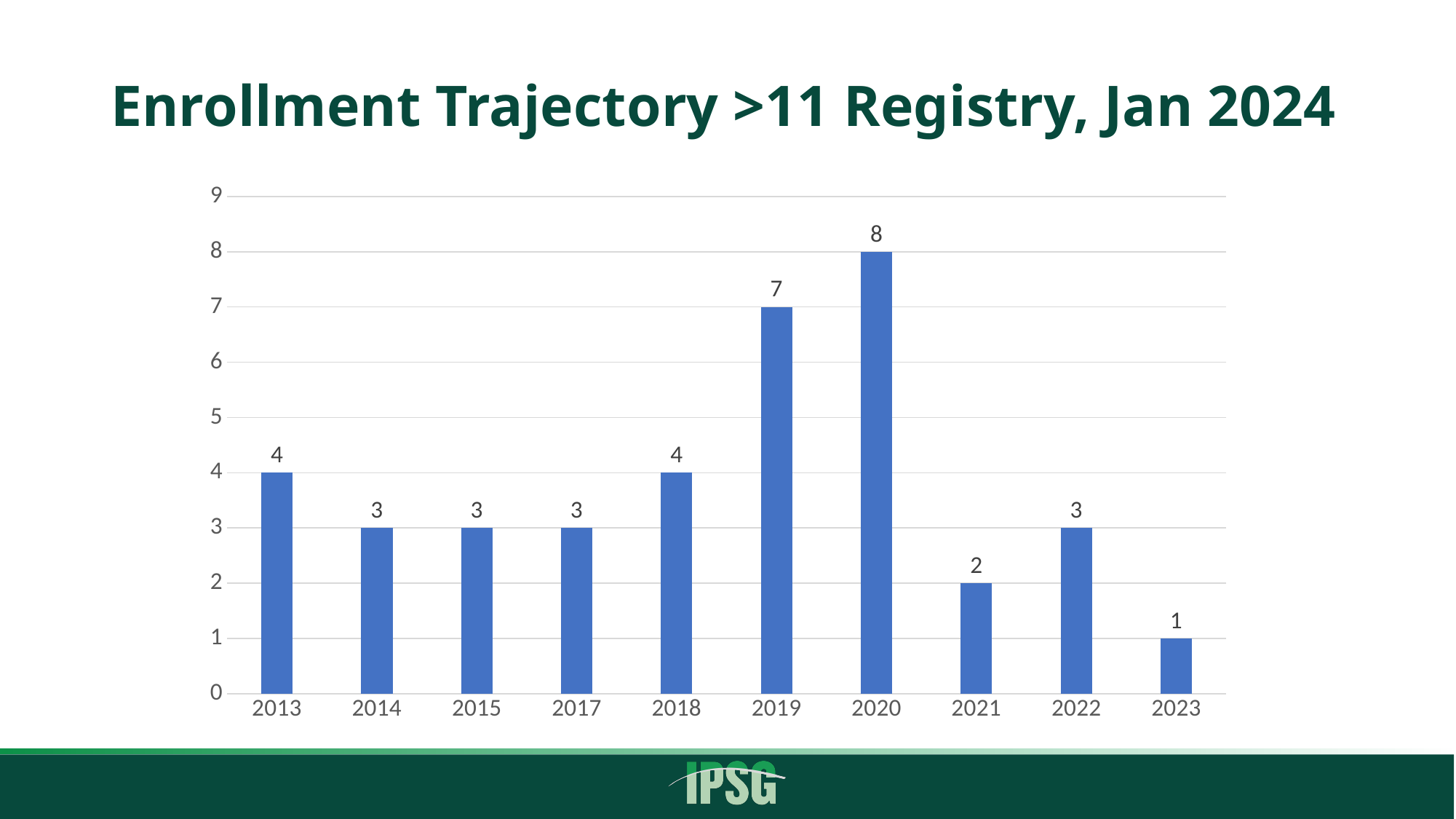
Which year has the highest enrollment? 2020 What kind of chart is shown on the slide? Bar chart What is the title of the chart? Enrollment Trajectory >11 Registry, Jan 2024 What is the enrollment value for 2013? 4 What is the difference between the enrollment values for 2019 and 2021? 5 What is the enrollment value for 2020? 8 Which year has the lowest enrollment? 2023 How many years are shown on the x axis? 10 What is the enrollment value for 2023? 1 What is the enrollment value for 2021? 2 Which year has a larger enrollment value, 2018 or 2022? 2018 What is the difference between the enrollment values for 2020 and 2019? 1